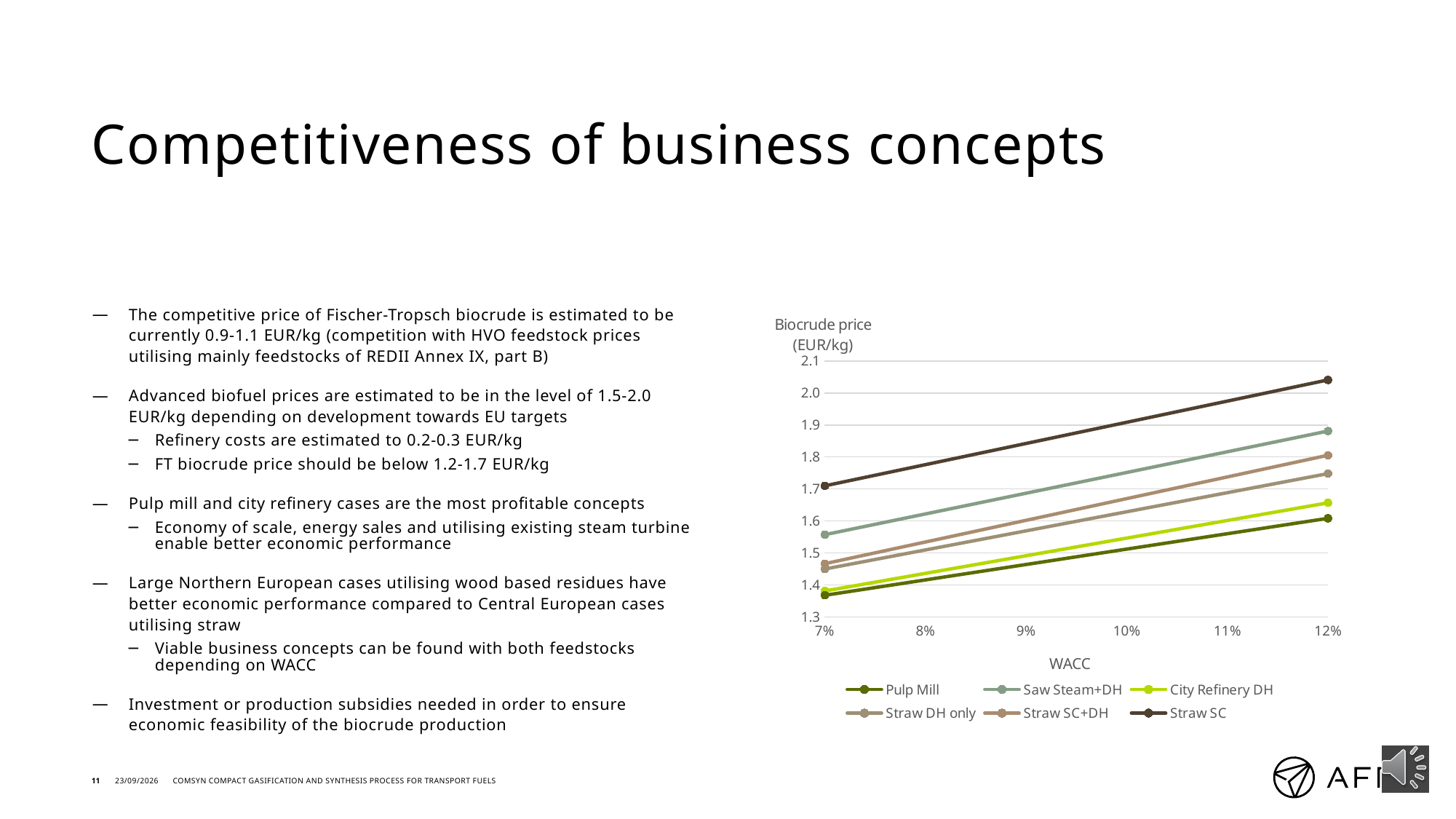
How many WACC values are labelled on the x axis of the chart? 6 Do the biocrude prices rise or fall as WACC increases from 7% to 12%? rise Is the value for Pulp Mill at 7% WACC greater or less than 1.4? less Which series has the lowest biocrude price at 12% WACC? Pulp Mill At 7% WACC, which is larger: Saw Steam+DH or Straw SC? Straw SC What kind of chart is shown on the slide? line chart Is the value for Straw SC at 12% WACC greater or less than 2.0? greater What is the title of the x axis of the chart? WACC Is the value for Saw Steam+DH at 12% WACC greater or less than 1.8? greater How many series does the legend of the chart list? 6 Which series has the highest biocrude price at 12% WACC? Straw SC At 12% WACC, which is larger: Straw SC+DH or Straw DH only? Straw SC+DH